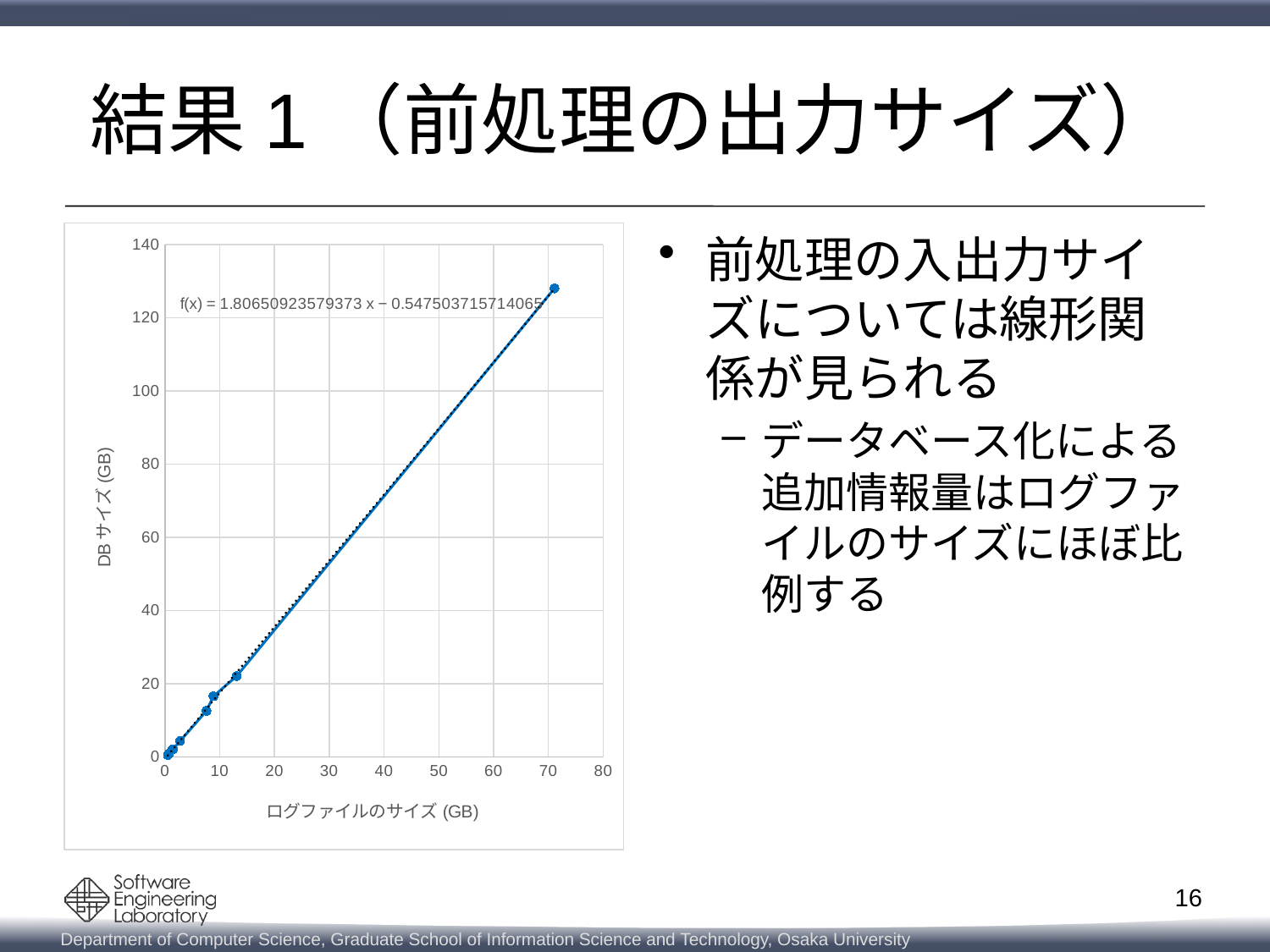
What kind of chart is shown on the slide? scatter chart Do the DB size values rise or fall as the log file size increases along the x axis? rise What is the intercept of the fitted line f(x) shown on the chart? −0.547503715714065 What is the highest value shown on the y axis of the chart? 140 What is the highest value shown on the x axis of the chart? 80 Which data point has the highest DB size: the one at about 71 GB log file size or the one at about 13 GB? the one at about 71 GB What is the slope of the fitted line f(x) shown on the chart? 1.80650923579373 What is the label of the y axis of the chart? DB サイズ (GB) Is the DB size of the data point at about 13 GB log file size greater or less than 40? less What is the label of the x axis of the chart? ログファイルのサイズ (GB) Is the DB size of the rightmost data point (at about 71 GB log file size) greater or less than 120? greater